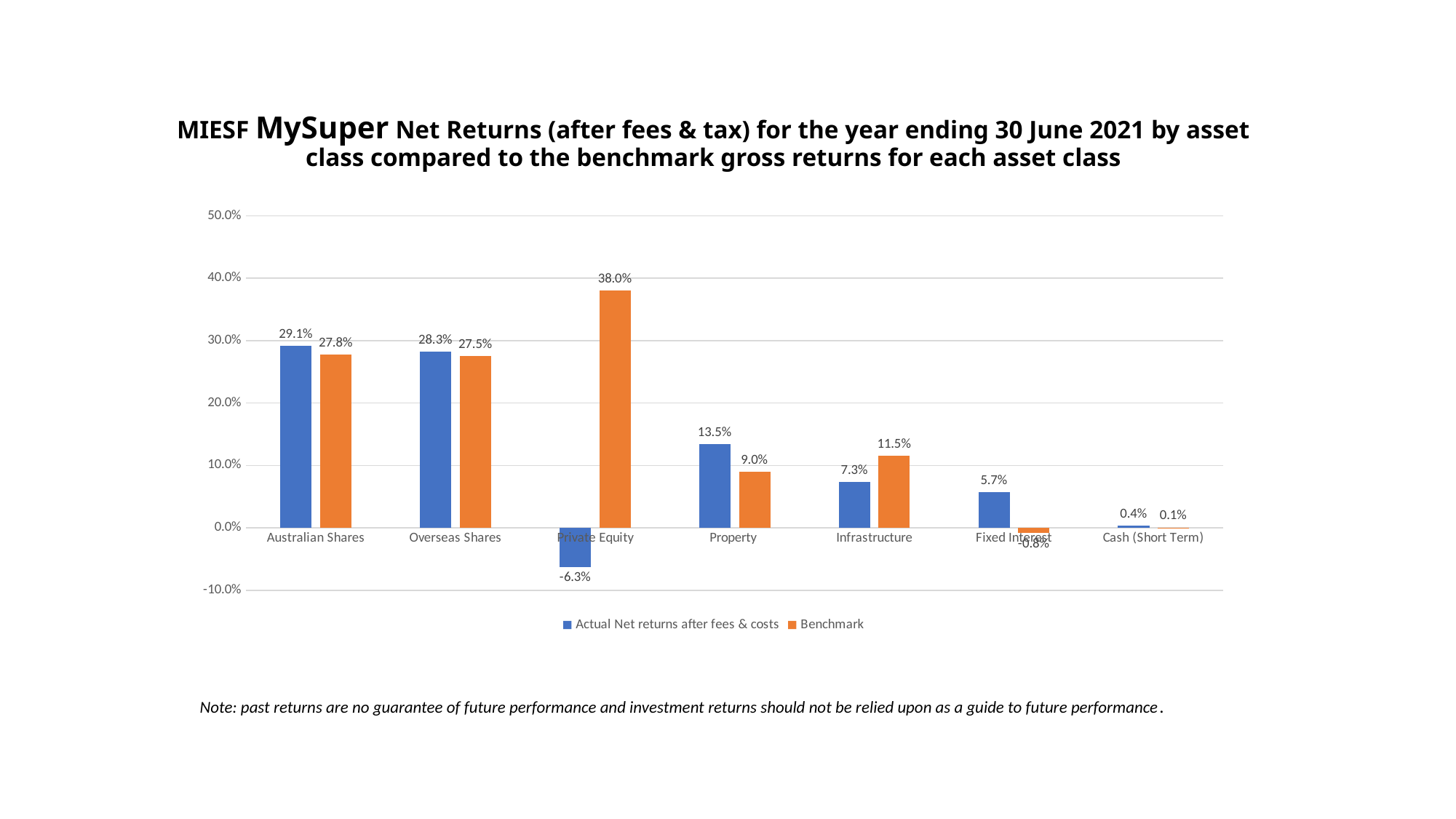
How many series does the legend list? 2 What is the Benchmark value for Private Equity? 38.0% What is the Actual Net return after fees & costs for Australian Shares? 29.1% What kind of chart is shown on the slide? Bar chart What is the Actual Net return after fees & costs for Private Equity? -6.3% What is the difference between the Actual Net return and the Benchmark for Property? 4.5% Is the Benchmark value for Private Equity greater or less than 30.0%? greater What is the Benchmark value for Fixed Interest? -0.8% How many asset classes are shown on the x axis? 7 Which asset class has the lowest Actual Net return after fees & costs? Private Equity For Infrastructure, which is larger: the Actual Net return after fees & costs or the Benchmark? Benchmark Which asset class has the highest Benchmark value? Private Equity